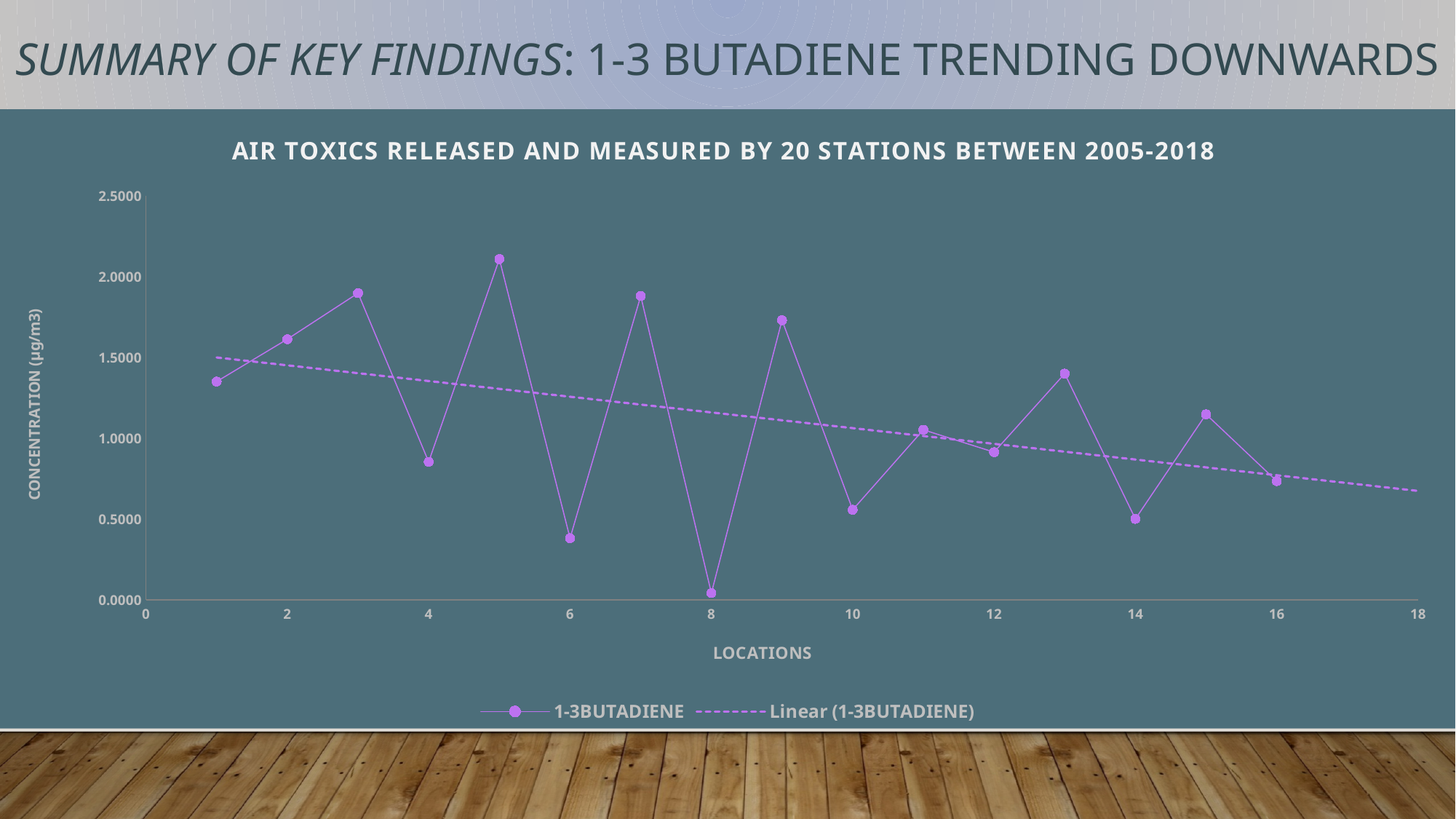
What kind of chart is shown on the slide? line chart What is the title of the chart? AIR TOXICS RELEASED AND MEASURED BY 20 STATIONS BETWEEN 2005-2018 At which location is the 1-3BUTADIENE concentration lowest? 8 How many entries does the chart legend list? 2 Does the dashed linear trendline for 1-3BUTADIENE rise or fall as the location number increases? fall Is the 1-3BUTADIENE value at location 6 greater or less than 0.5000? less Is the 1-3BUTADIENE value at location 5 greater or less than 2.0000? greater How many data points are plotted for the 1-3BUTADIENE series? 16 Is the 1-3BUTADIENE value at location 14 greater or less than 1.0000? less Which location has the larger 1-3BUTADIENE concentration, location 3 or location 4? location 3 At which location is the 1-3BUTADIENE concentration highest? 5